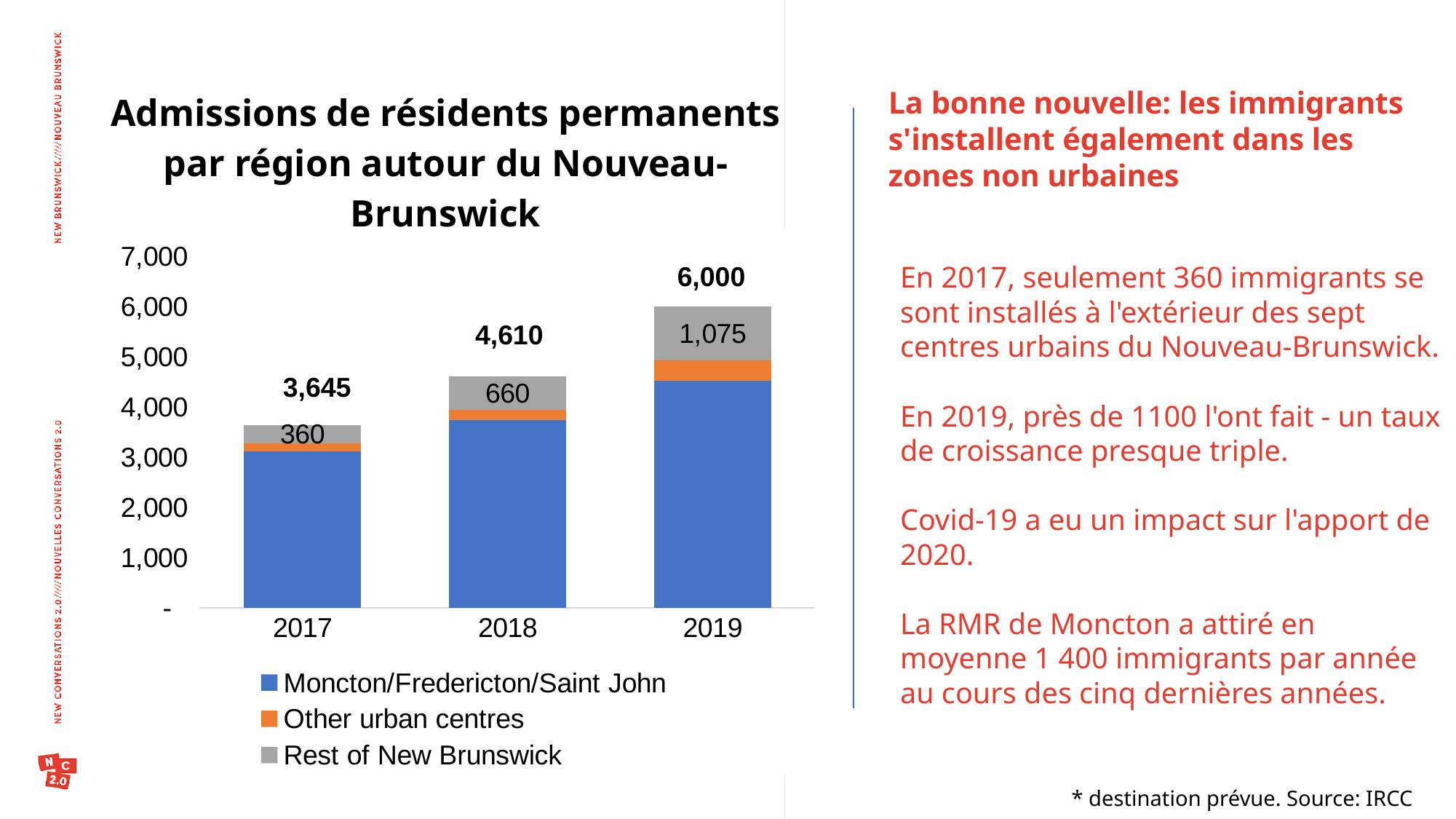
What kind of chart is shown on the slide? Stacked bar chart Do the total admissions rise or fall from 2017 to 2019? Rise Which year has the highest total admissions? 2019 By how much did the Rest of New Brunswick value increase from 2017 to 2019? 715 What value is shown for Rest of New Brunswick in 2018? 660 Is the Moncton/Fredericton/Saint John value for 2019 greater or less than 4,000? greater How many series does the legend list? 3 What is the total number of permanent resident admissions shown for 2017? 3,645 What is the difference between the total admissions in 2019 and in 2017? 2,355 What is the total number of permanent resident admissions shown for 2019? 6,000 Which year has the lowest total admissions? 2017 What value is shown for Rest of New Brunswick in 2019? 1,075